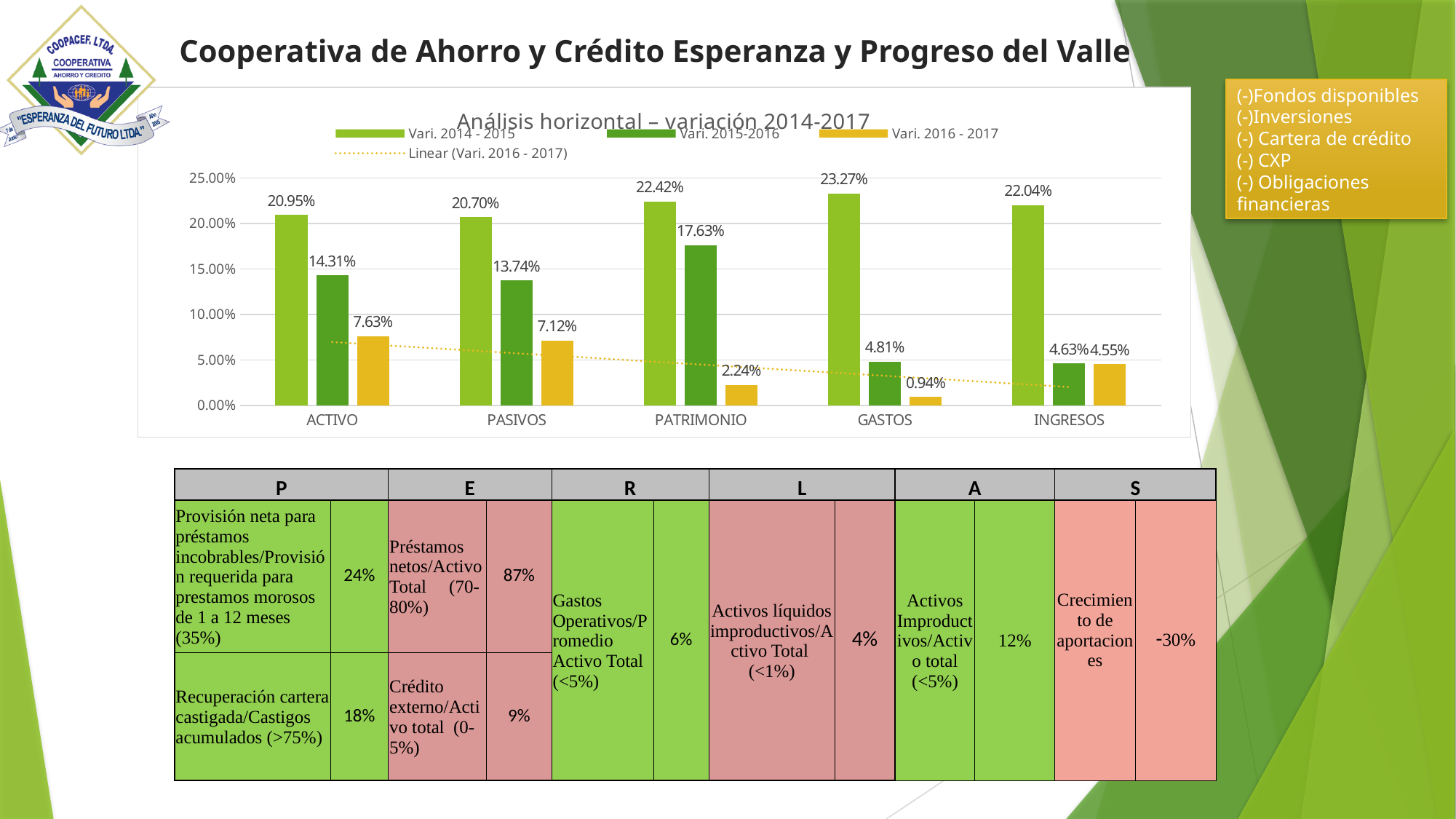
Which is larger: the Vari. 2015-2016 value for PATRIMONIO or for PASIVOS? PATRIMONIO What is the Vari. 2015-2016 value for ACTIVO? 14.31% What is the Vari. 2014 - 2015 value for GASTOS? 23.27% How many categories are shown on the x axis of the chart? 5 Which category has the lowest Vari. 2016 - 2017 value? GASTOS What is the difference between the Vari. 2014 - 2015 and Vari. 2015-2016 values for ACTIVO? 6.64% What is the Vari. 2016 - 2017 value for PATRIMONIO? 2.24% Which category has the highest Vari. 2014 - 2015 value? GASTOS Which category has the highest Vari. 2015-2016 value? PATRIMONIO Is the Vari. 2015-2016 value for INGRESOS greater or less than 5.00%? less How many entries does the chart's legend list? 4 What kind of chart is shown on the slide? bar chart